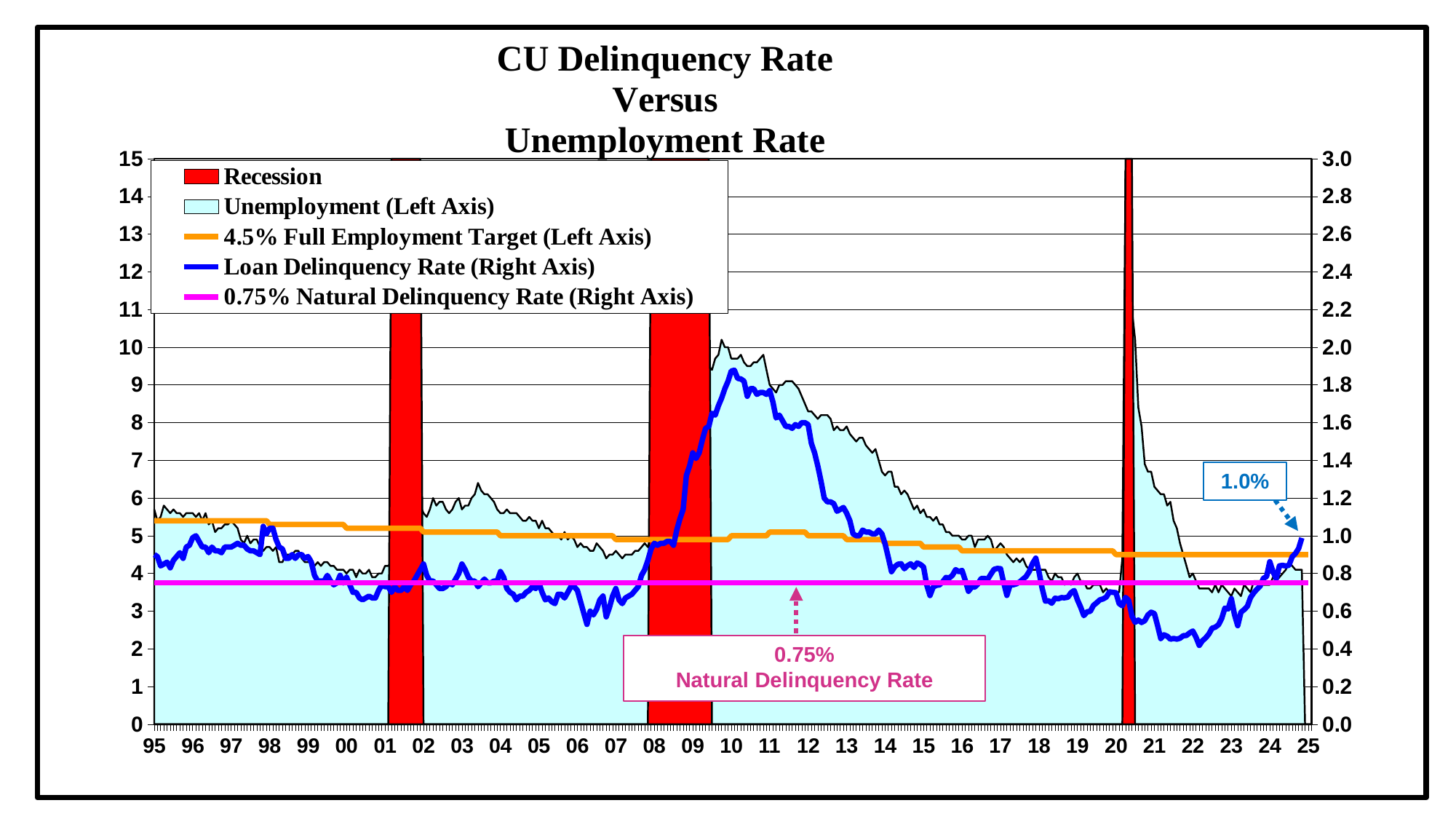
What colour are the recession bands? Red Which is larger, the unemployment rate in 2010 or in 2019? 2010 Does the Loan Delinquency Rate rise or fall from 2022 to 2025? rise In which year does the unemployment rate reach its highest point? 2020 How many recession bands are shaded on the chart? 3 What is the title of the chart? CU Delinquency Rate Versus Unemployment Rate What value is labelled for the Loan Delinquency Rate at the end of the series in 2025? 1.0% Is the peak unemployment rate in 2020 greater or less than 12 on the left axis? greater What is the Natural Delinquency Rate shown by the magenta line? 0.75% Is the unemployment rate in 2010 greater or less than 8 on the left axis? greater Is the Loan Delinquency Rate in 2022 greater or less than 0.6 on the right axis? less How many series does the legend list? 5